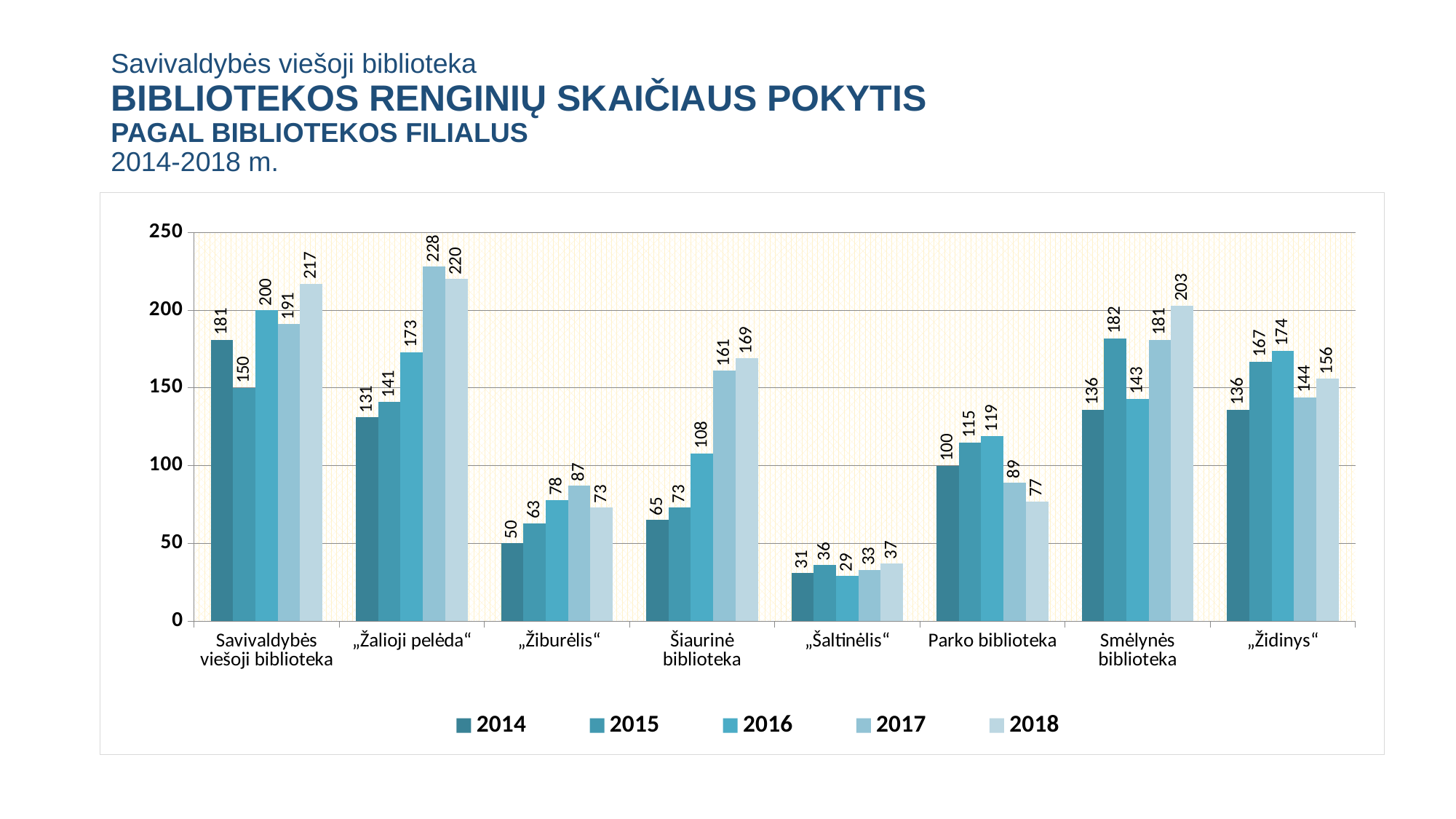
Which year does the darkest bar colour in the legend represent? 2014 What kind of chart is shown on the slide? bar chart Which branch has the highest value in 2014? Savivaldybės viešoji biblioteka What is the value for „Žalioji pelėda“ in 2017? 228 Which is larger: the 2015 value for Smėlynės biblioteka or the 2015 value for „Židinys“? Smėlynės biblioteka How many series does the legend list? 5 How many library branches (categories) are shown on the x axis? 8 Which branch has the lowest value in 2018? „Šaltinėlis“ What is the value for „Šaltinėlis“ in 2016? 29 What is the difference between the 2018 and 2014 values for Šiaurinė biblioteka? 104 Do the values for Parko biblioteka rise or fall from 2016 to 2018? fall What is the value for Smėlynės biblioteka in 2018? 203